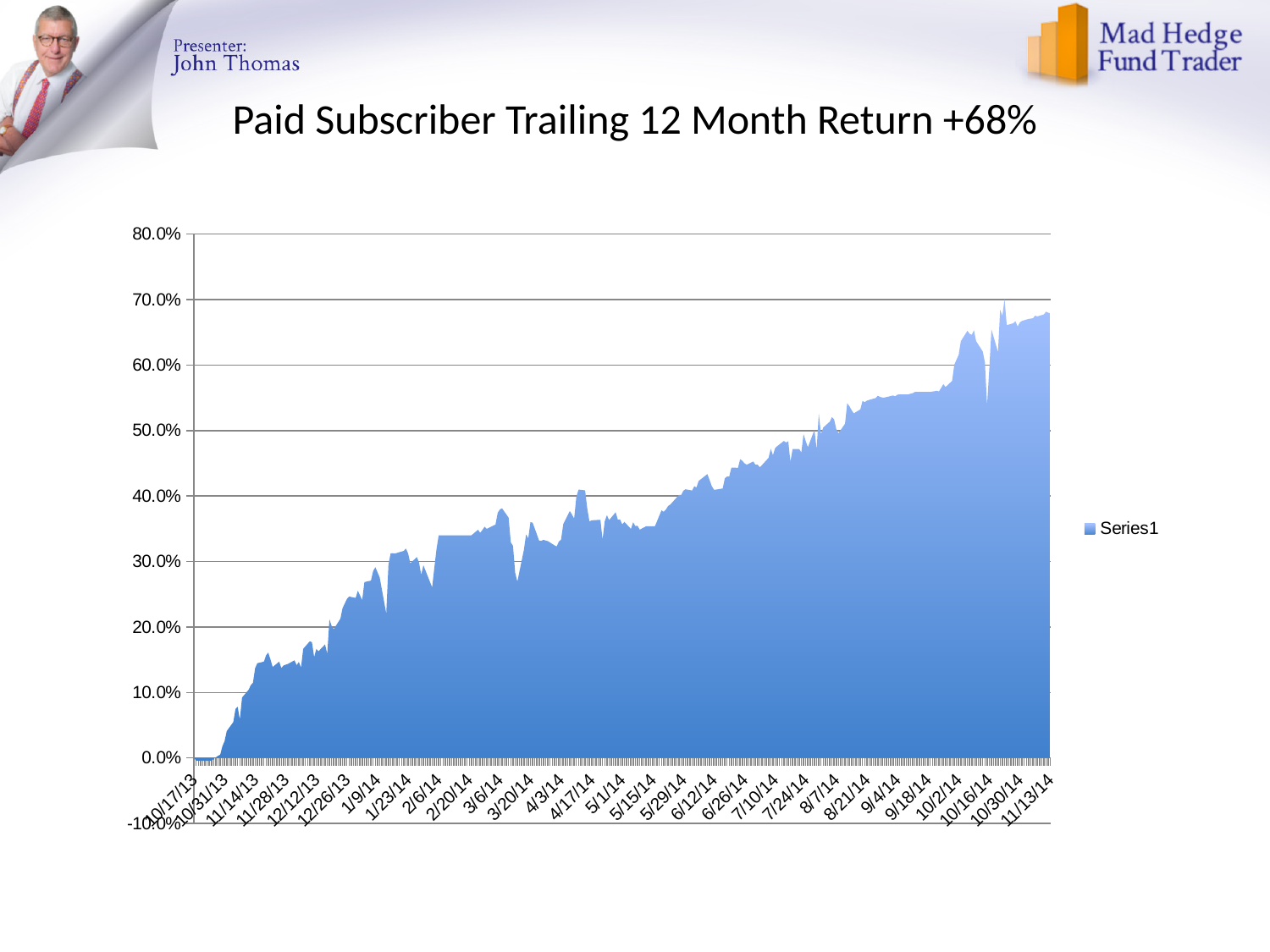
Is the value for 1/9/14 greater or less than 40%? less What kind of chart is shown on the slide? area chart Is the value for 12/12/13 greater or less than 30%? less What is the name of the series shown in the legend? Series1 How many series does the legend list? 1 Is the value for 8/7/14 greater or less than 40%? greater What is the title of the chart on the slide? Paid Subscriber Trailing 12 Month Return +68% Do the values generally rise or fall from 10/17/13 to 11/13/14? rise Which date has the larger value, 11/13/14 or 10/17/13? 11/13/14